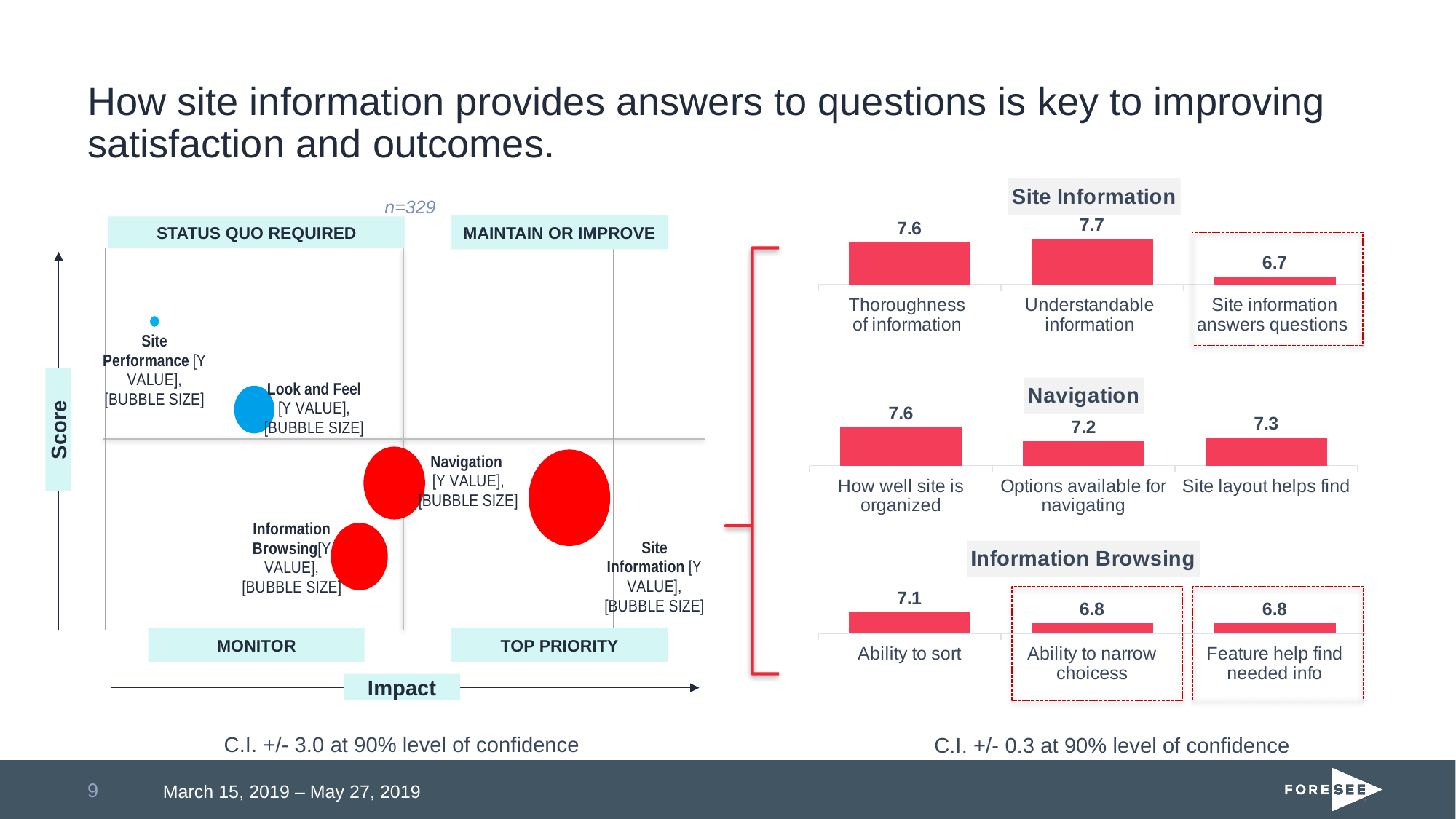
In the Information Browsing bar chart, what is the value for Ability to sort? 7.1 In the Site Information bar chart, what is the difference between Understandable information and Site information answers questions? 1.0 In the Site Information bar chart, what is the value for Site information answers questions? 6.7 In the Information Browsing bar chart, what is the difference between Ability to sort and Ability to narrow choicess? 0.3 How many categories are shown in the Information Browsing bar chart? 3 In the Navigation bar chart, which category has the lowest value? Options available for navigating In the bubble chart on the left, how many bubbles are plotted? 5 What kind of chart is the chart on the left with the Score and Impact axes? Bubble chart In the Navigation bar chart, which is larger: How well site is organized or Site layout helps find? How well site is organized In the Site Information bar chart, which category has the highest value? Understandable information In the Navigation bar chart, what is the value for Options available for navigating? 7.2 In the Site Information bar chart, what is the value for Thoroughness of information? 7.6